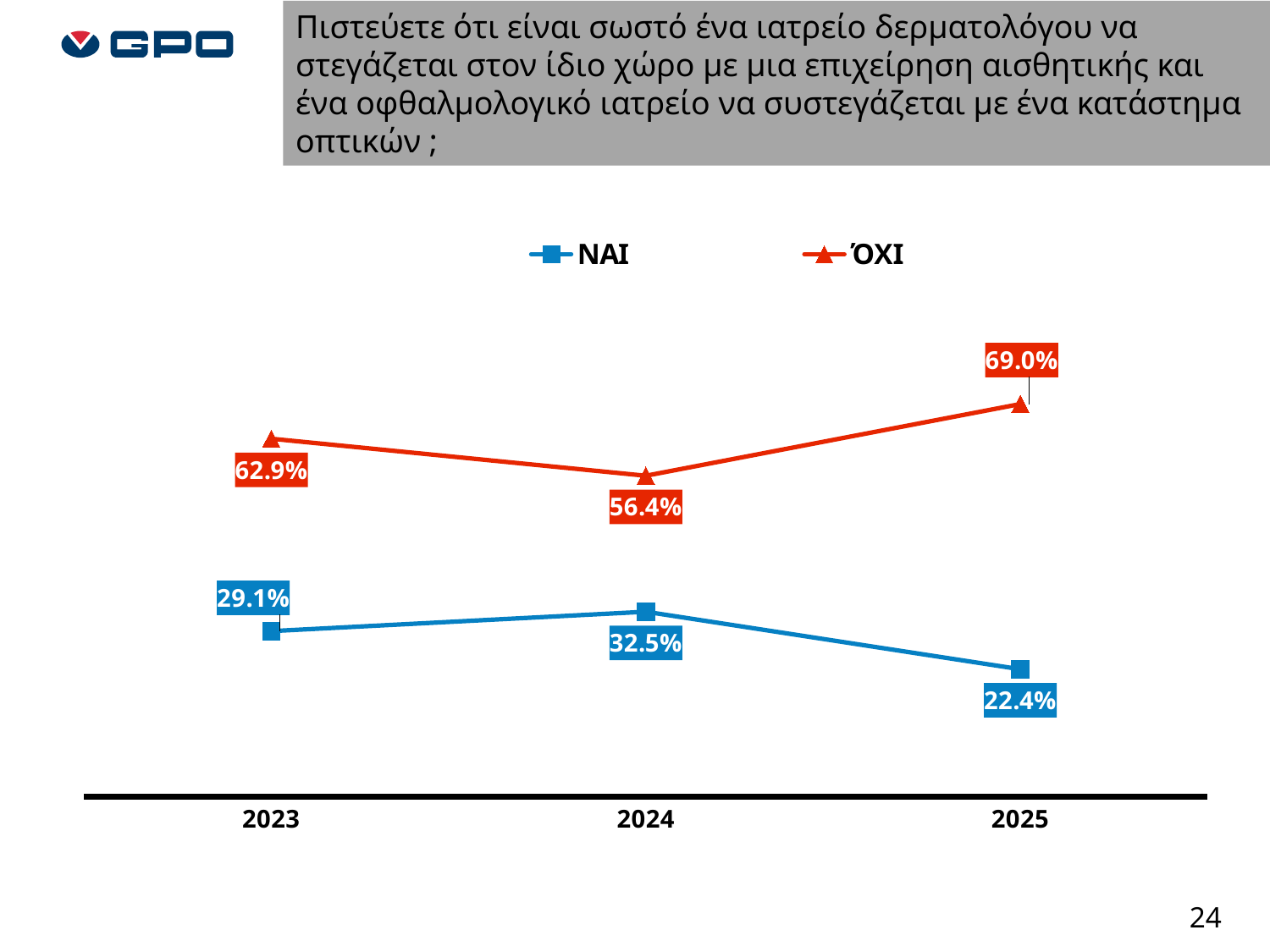
Does the ΝΑΙ series rise or fall from 2024 to 2025? fall How many years are shown on the x axis? 3 How many series does the legend list? 2 Which is larger in 2023, ΝΑΙ or ΌΧΙ? ΌΧΙ In which year is the ΝΑΙ series lowest? 2025 What is the difference between ΌΧΙ and ΝΑΙ in 2025? 46.6% What is the value for ΝΑΙ in 2024? 32.5% What is the value for ΌΧΙ in 2025? 69.0% What is the value for ΝΑΙ in 2023? 29.1% By how much did ΌΧΙ change from 2024 to 2025? 12.6% In which year is the ΌΧΙ series highest? 2025 What kind of chart is shown on the slide? line chart